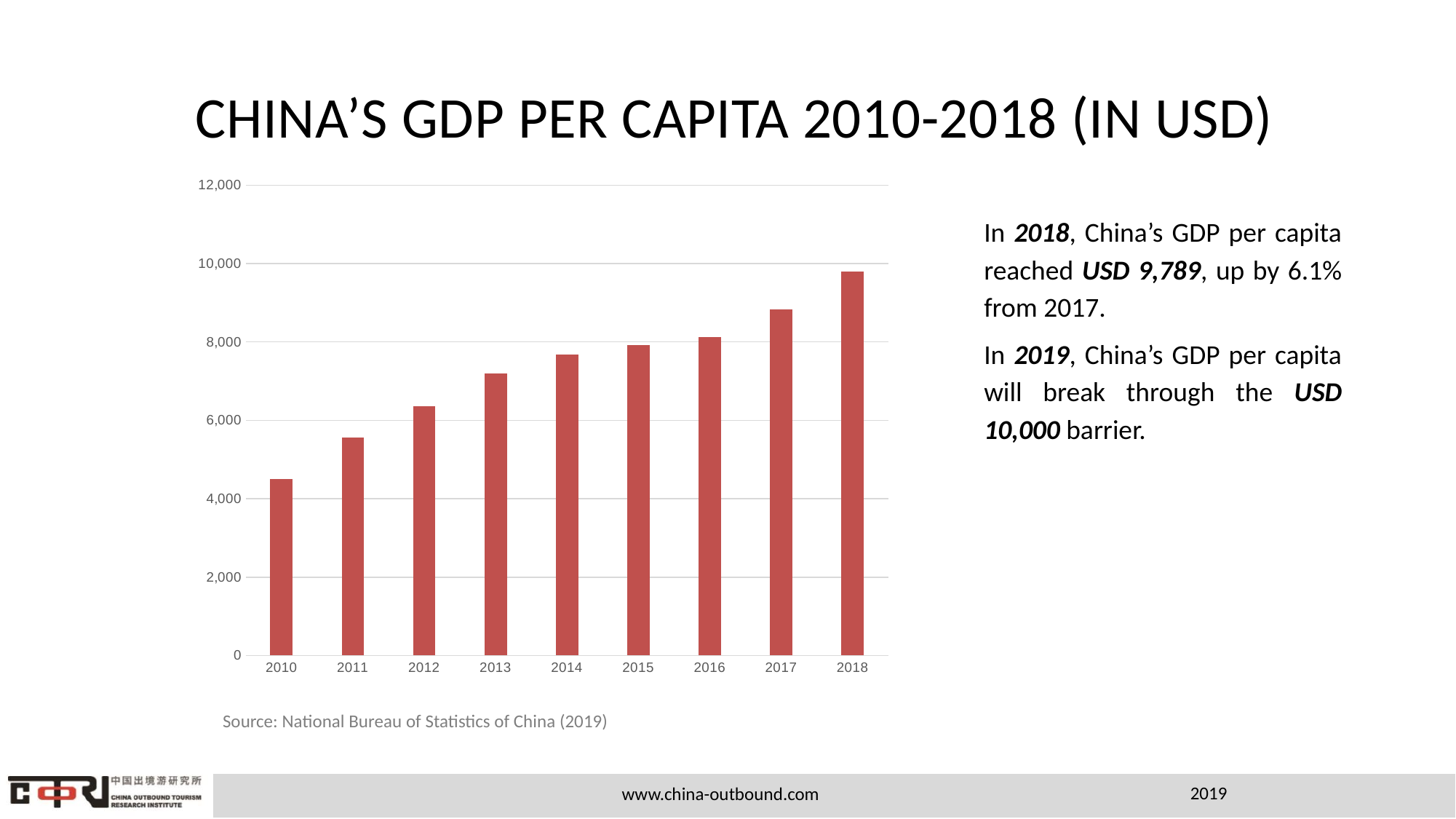
Which year has the larger GDP per capita, 2012 or 2011? 2012 Is the value for 2011 greater or less than 6,000? less What kind of chart is shown on the slide? Bar chart Is the value for 2018 greater or less than 10,000? less Do the values rise or fall from 2010 to 2018? Rise Is the value for 2017 greater or less than 8,000? greater Which year has the lowest GDP per capita in the chart? 2010 Which year has the highest GDP per capita in the chart? 2018 How many years are plotted in the chart? 9 What is the title of the chart? CHINA'S GDP PER CAPITA 2010-2018 (IN USD)